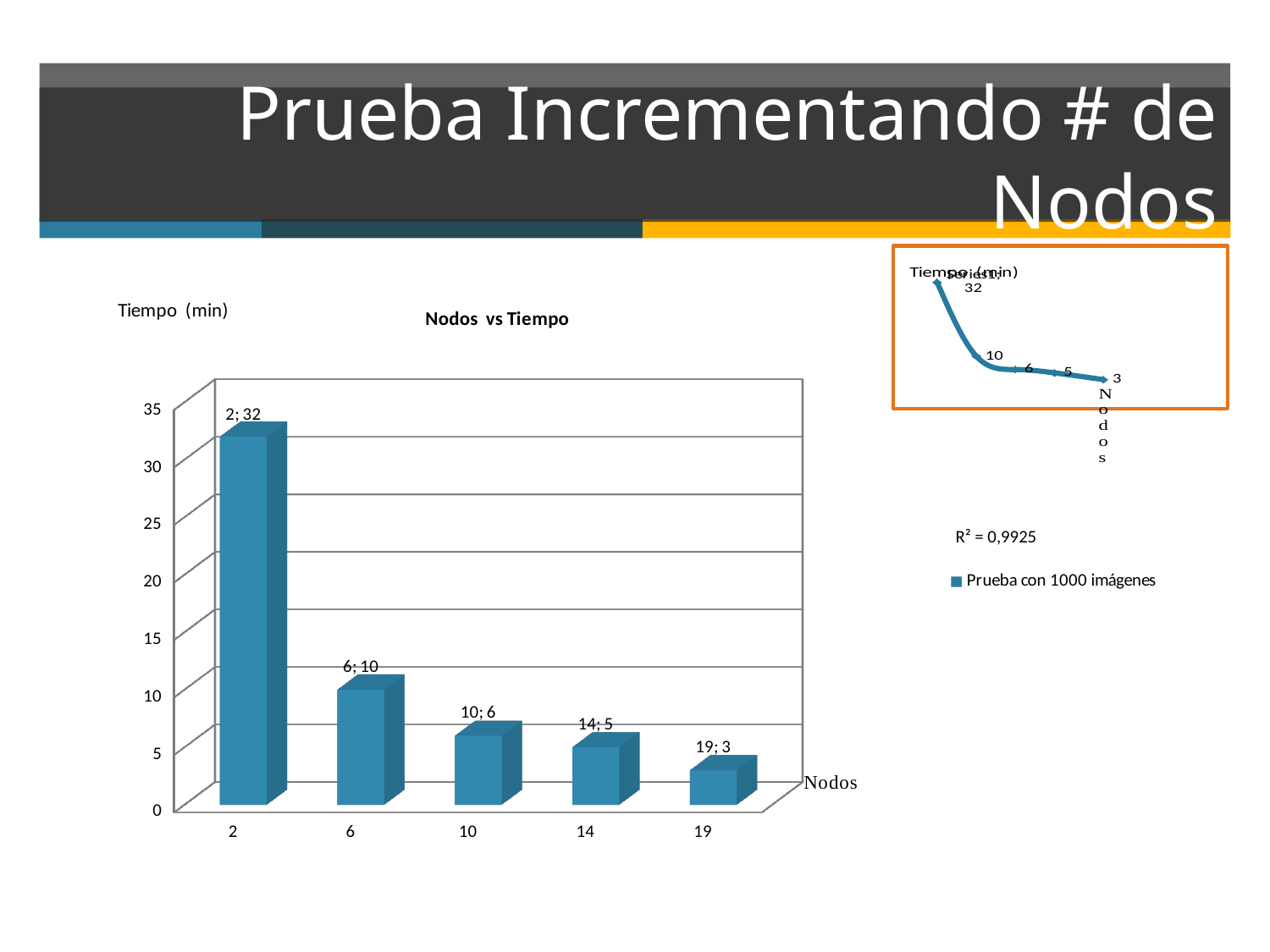
In the 'Nodos vs Tiempo' bar chart, what is the time value for 2 nodes? 32 In the 'Nodos vs Tiempo' bar chart, what is the time value for 19 nodes? 3 What is the legend entry shown on the right side of the slide? Prueba con 1000 imágenes What kind of chart is the small chart in the top right of the slide? Line chart In the 'Nodos vs Tiempo' bar chart, what is the difference between the time for 2 nodes and the time for 6 nodes? 22 In the 'Nodos vs Tiempo' bar chart, which number of nodes has the highest time? 2 In the 'Nodos vs Tiempo' bar chart, do the time values rise or fall as the number of nodes increases? Fall In the 'Nodos vs Tiempo' bar chart, which number of nodes has the lowest time? 19 How many bars are shown in the 'Nodos vs Tiempo' bar chart? 5 In the 'Nodos vs Tiempo' bar chart, which has a larger time value, 10 nodes or 14 nodes? 10 nodes In the 'Nodos vs Tiempo' bar chart, what is the time value for 6 nodes? 10 What kind of chart is the large 'Nodos vs Tiempo' chart? Bar chart